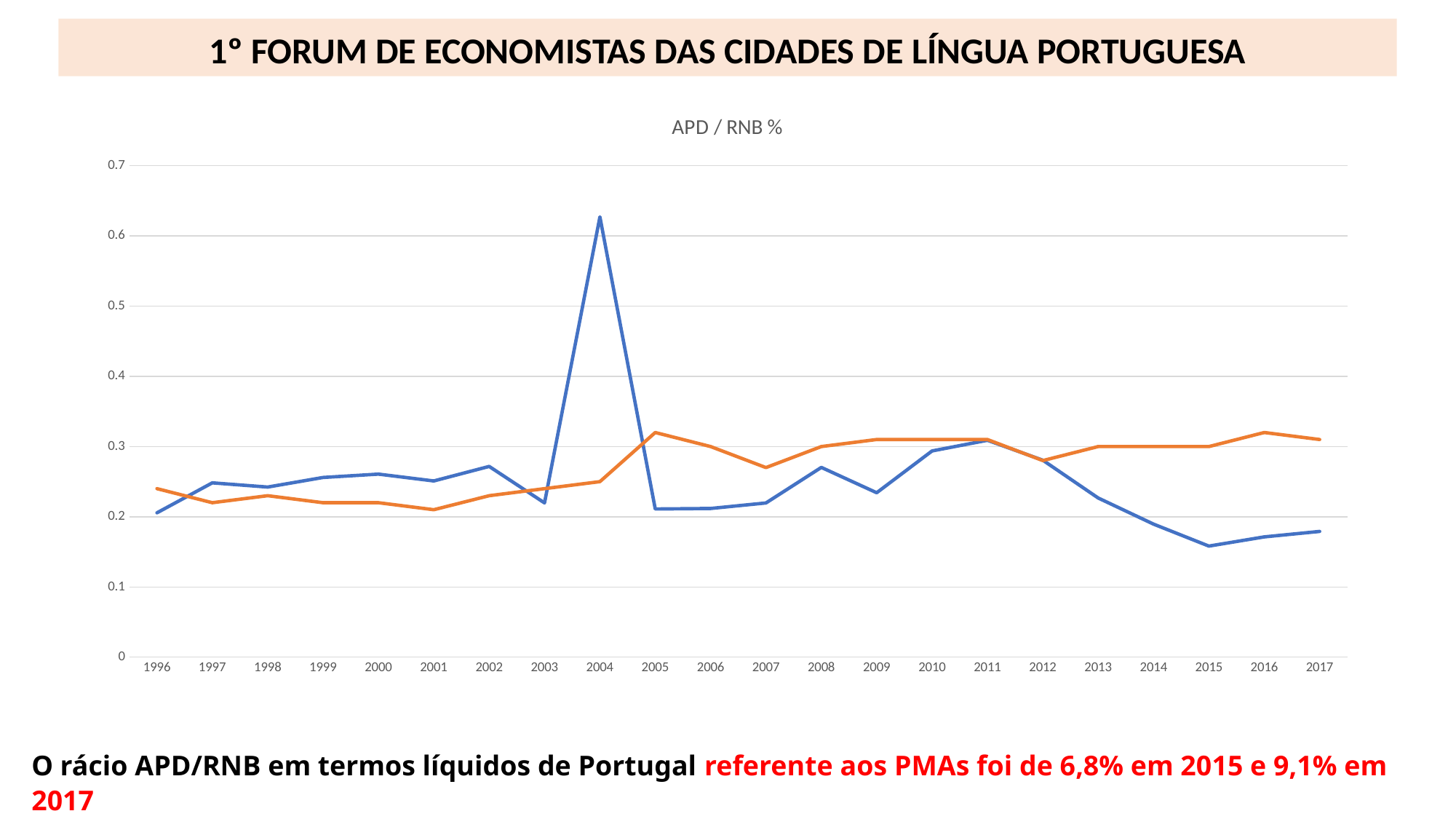
In 2009, which line has the higher value, the blue line or the orange line? orange line In which year does the blue line reach its highest value? 2004 Is the value of the orange line in 2007 greater or less than 0.3? less What is the title of the chart? APD / RNB % How many lines are plotted on the chart? 2 How many years are shown on the x axis of the chart? 22 Is the value of the blue line in 2015 greater or less than 0.2? less Does the orange line rise or fall between 2001 and 2005? rise Is the value of the blue line in 2004 greater or less than 0.6? greater In which year does the blue line reach its lowest value? 2015 What kind of chart is shown on the slide? line chart Does the blue line rise or fall between 2011 and 2015? fall